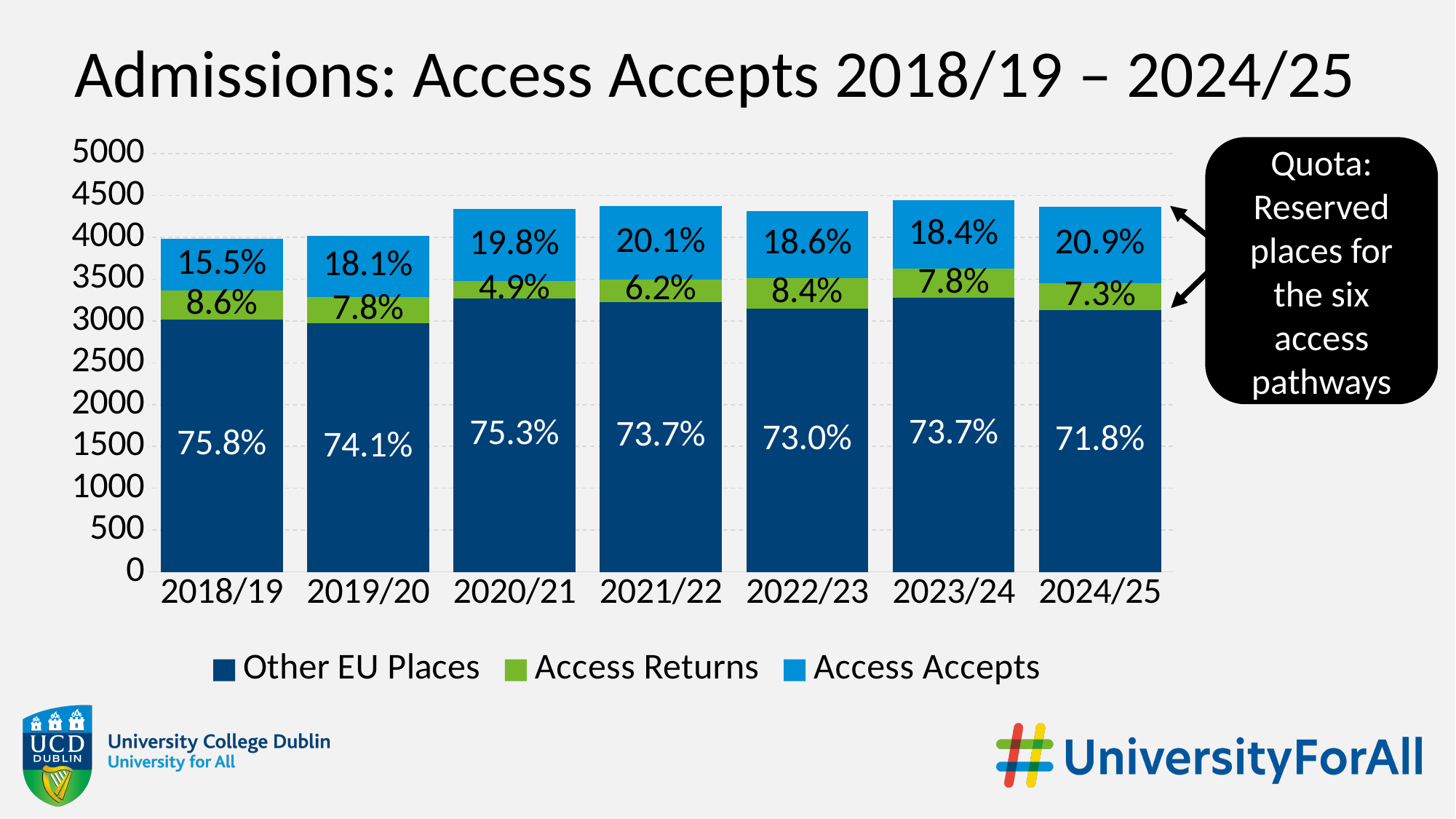
What is the difference in percentage points between the Access Accepts share in 2024/25 and in 2018/19? 5.4 percentage points In which year is the Access Accepts percentage highest? 2024/25 Is the total height of the 2020/21 bar greater or less than 4000? greater What is the Access Returns percentage for 2020/21? 4.9% What kind of chart is shown on the slide? Stacked bar chart What is the Other EU Places percentage for 2019/20? 74.1% How many series does the chart's legend list? 3 In which year is the Access Returns percentage lowest? 2020/21 How many academic years are shown on the x axis of the chart? 7 What is the Access Accepts percentage for 2024/25? 20.9% Which year has the larger Access Accepts percentage, 2021/22 or 2022/23? 2021/22 Does the Access Accepts percentage rise or fall from 2018/19 to 2021/22? Rise